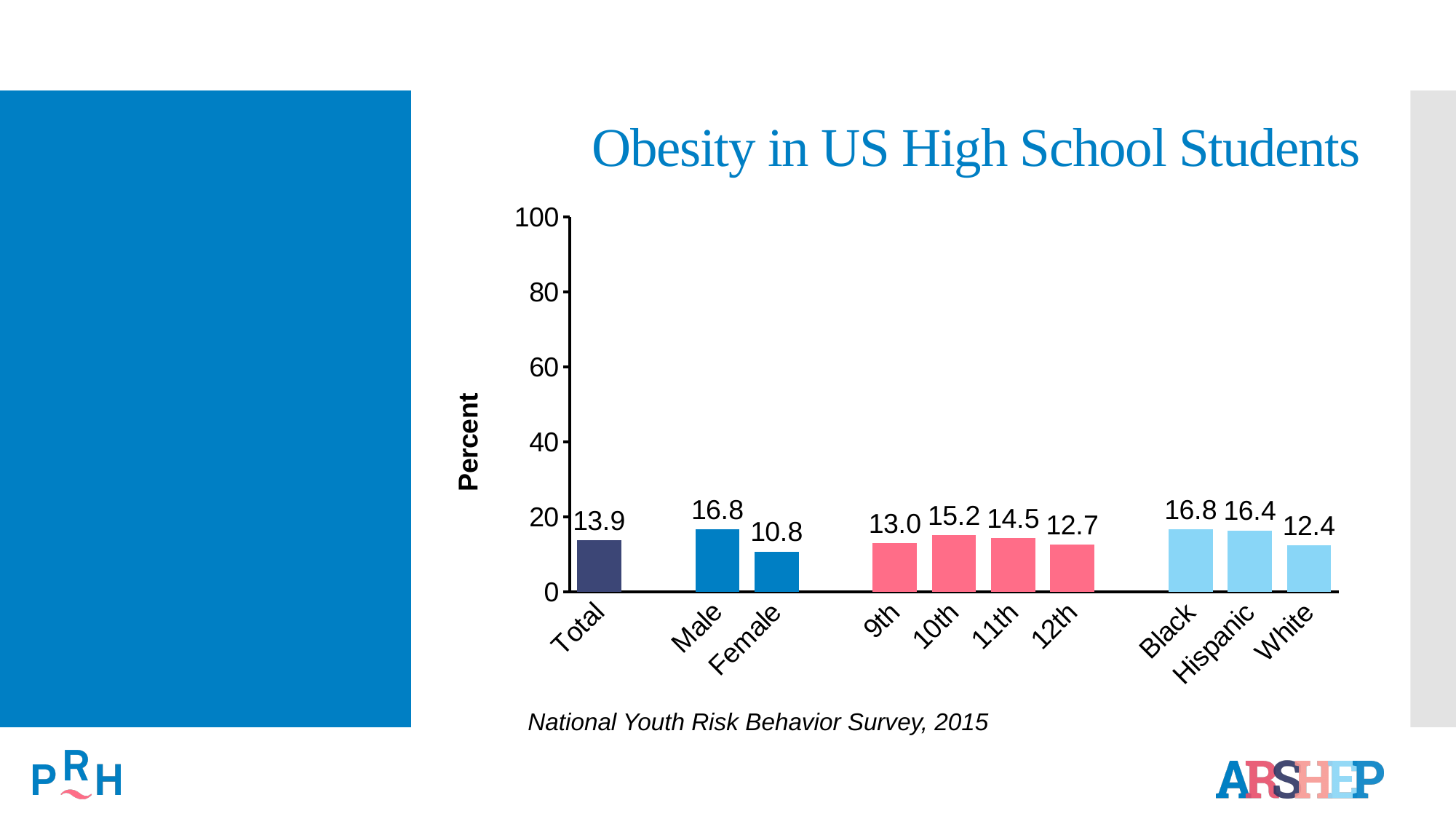
Which grade level (9th to 12th) has the highest value? 10th What is the value for Total? 13.9 Which is larger, the value for Black or the value for White? Black What is the title of the chart? Obesity in US High School Students What is the value for Hispanic? 16.4 What is the difference between the values for Male and Female? 6.0 What is the value for Female? 10.8 Is the value for 12th greater or less than 20? less How many categories are shown on the x axis? 10 Which category has the lowest value? Female What is the value for 10th? 15.2 What kind of chart is shown? bar chart